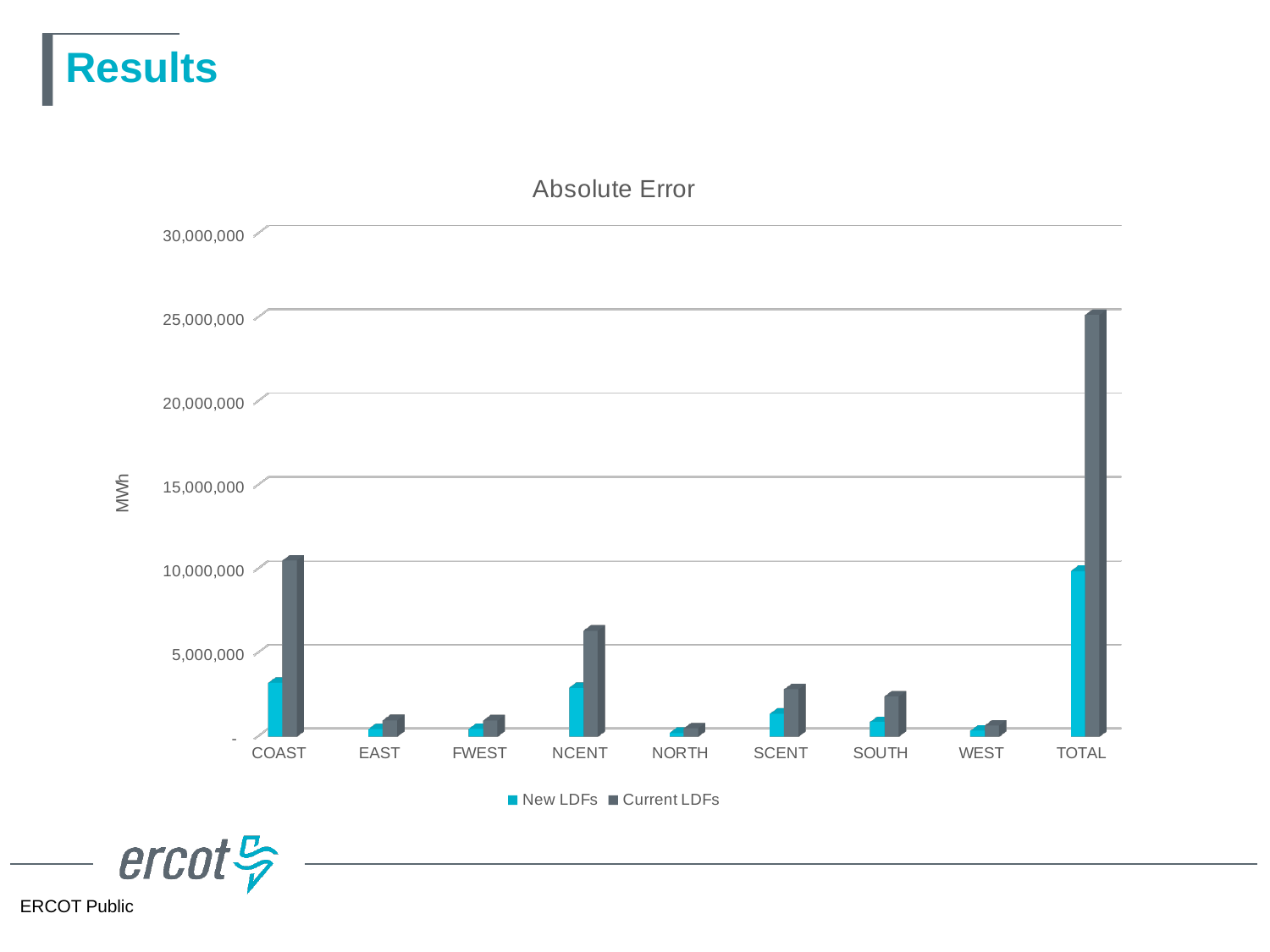
Is the Current LDFs value for TOTAL greater or less than 20,000,000? greater Which category has the lowest Current LDFs value? NORTH What unit is shown on the y axis label? MWh Among the regions other than TOTAL, which has the highest Current LDFs value? COAST Which category has the highest Current LDFs value? TOTAL For COAST, which is larger: the New LDFs value or the Current LDFs value? Current LDFs What is the title of the chart? Absolute Error How many series does the legend list? 2 Is the New LDFs value for COAST greater or less than 5,000,000? less What kind of chart is shown on the slide? bar chart How many categories are shown on the x axis? 9 Is the Current LDFs value for NCENT greater or less than 5,000,000? greater